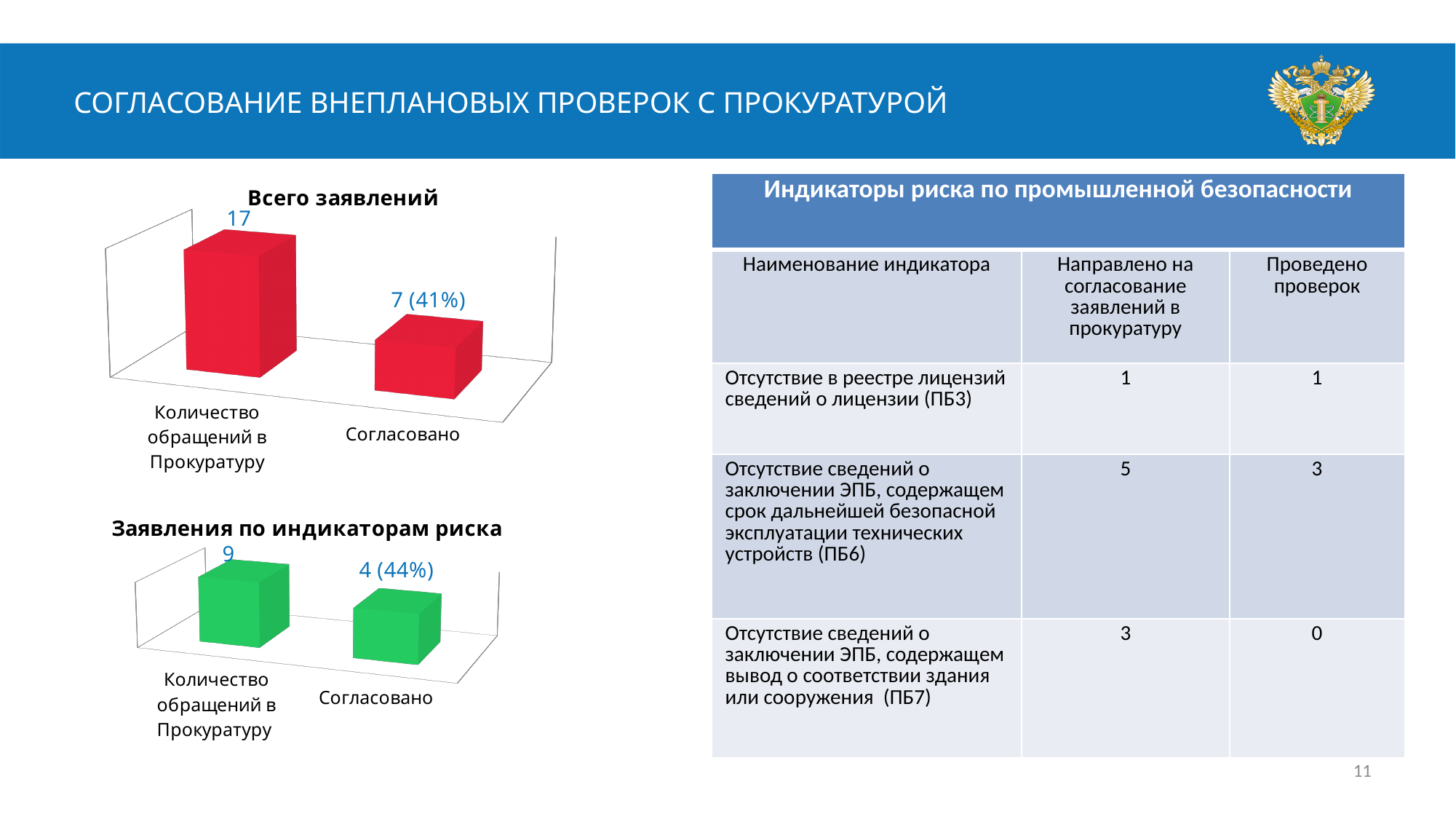
In the chart titled "Заявления по индикаторам риска", what is the value for "Количество обращений в Прокуратуру"? 9 In the chart titled "Заявления по индикаторам риска", what data label is shown for "Согласовано"? 4 (44%) In the chart titled "Заявления по индикаторам риска", what is the difference between the number of applications sent to the prosecutor's office and the number approved? 5 What type of chart is the chart titled "Заявления по индикаторам риска"? bar chart In the chart titled "Всего заявлений", what data label is shown for "Согласовано"? 7 (41%) In the chart titled "Всего заявлений", what is the value for "Количество обращений в Прокуратуру"? 17 How many categories are plotted in the chart titled "Всего заявлений"? 2 What colour are the bars in the chart titled "Заявления по индикаторам риска"? green In the chart titled "Всего заявлений", which category has the higher value? Количество обращений в Прокуратуру Is the value for "Количество обращений в Прокуратуру" in the chart titled "Всего заявлений" larger or smaller than the same category in the chart titled "Заявления по индикаторам риска"? larger In the chart titled "Заявления по индикаторам риска", which category has the lower value? Согласовано In the chart titled "Всего заявлений", what is the difference between the number of applications sent to the prosecutor's office and the number approved? 10